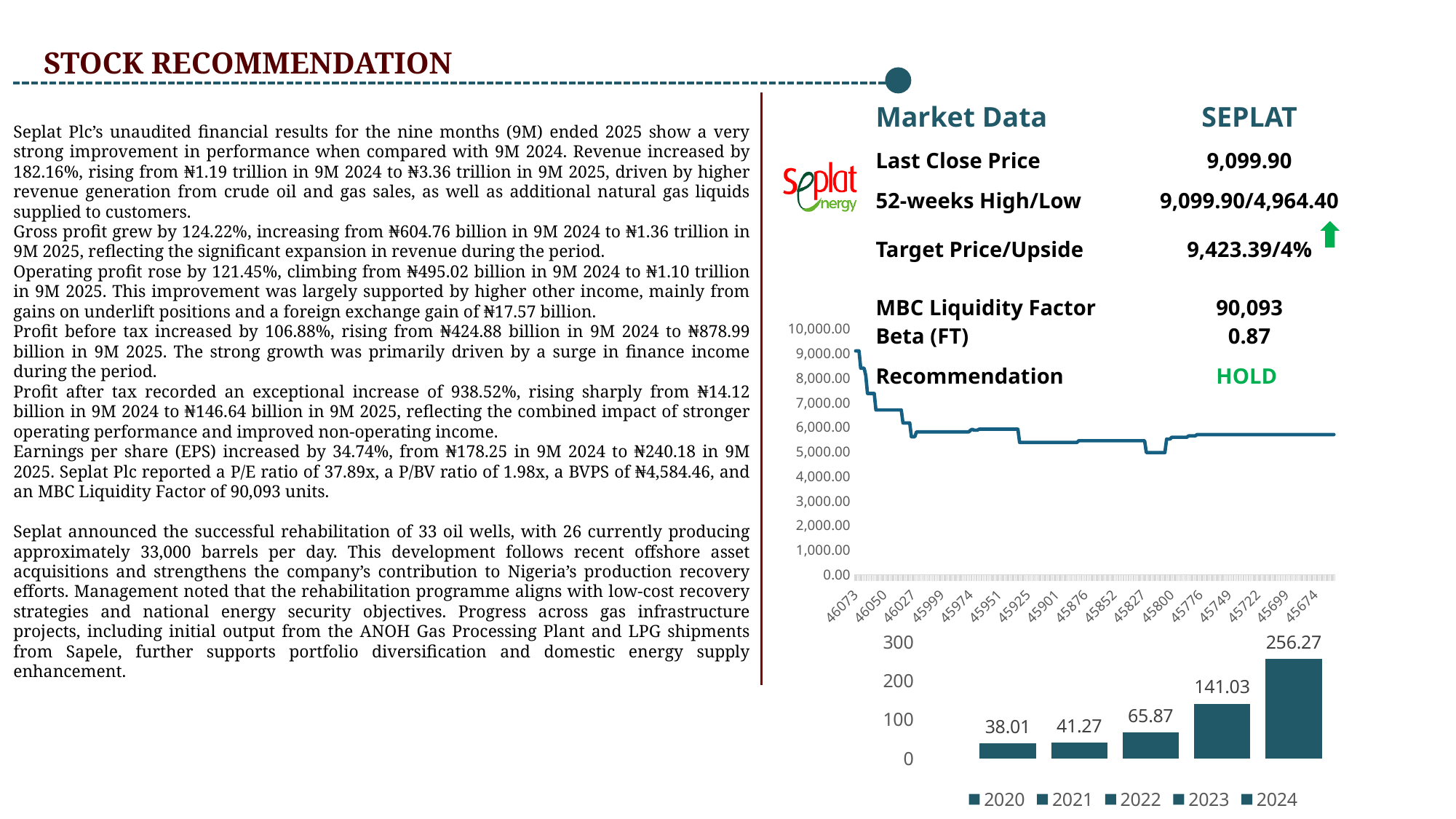
In the bar chart at the bottom right, what is the value for 2024? 256.27 In the bar chart at the bottom right, what is the difference between the values for 2024 and 2023? 115.24 In the bar chart at the bottom right, what is the value for 2022? 65.87 In the line chart on the right, do the values rise or fall moving from left to right along the x axis? fall In the line chart on the right, is the value at the leftmost point (46073) greater or less than 8,000.00? greater In the bar chart at the bottom right, which year has the lowest value? 2020 What kind of chart is the chart in the middle right of the slide showing values from 0.00 to 10,000.00? line chart In the bar chart at the bottom right, do the values rise or fall from 2020 to 2024? rise In the bar chart at the bottom right, what is the value for 2020? 38.01 In the bar chart at the bottom right, which year has the highest value? 2024 In the bar chart at the bottom right, how many entries does the legend list? 5 In the bar chart at the bottom right, which is larger, the value for 2021 or the value for 2022? 2022